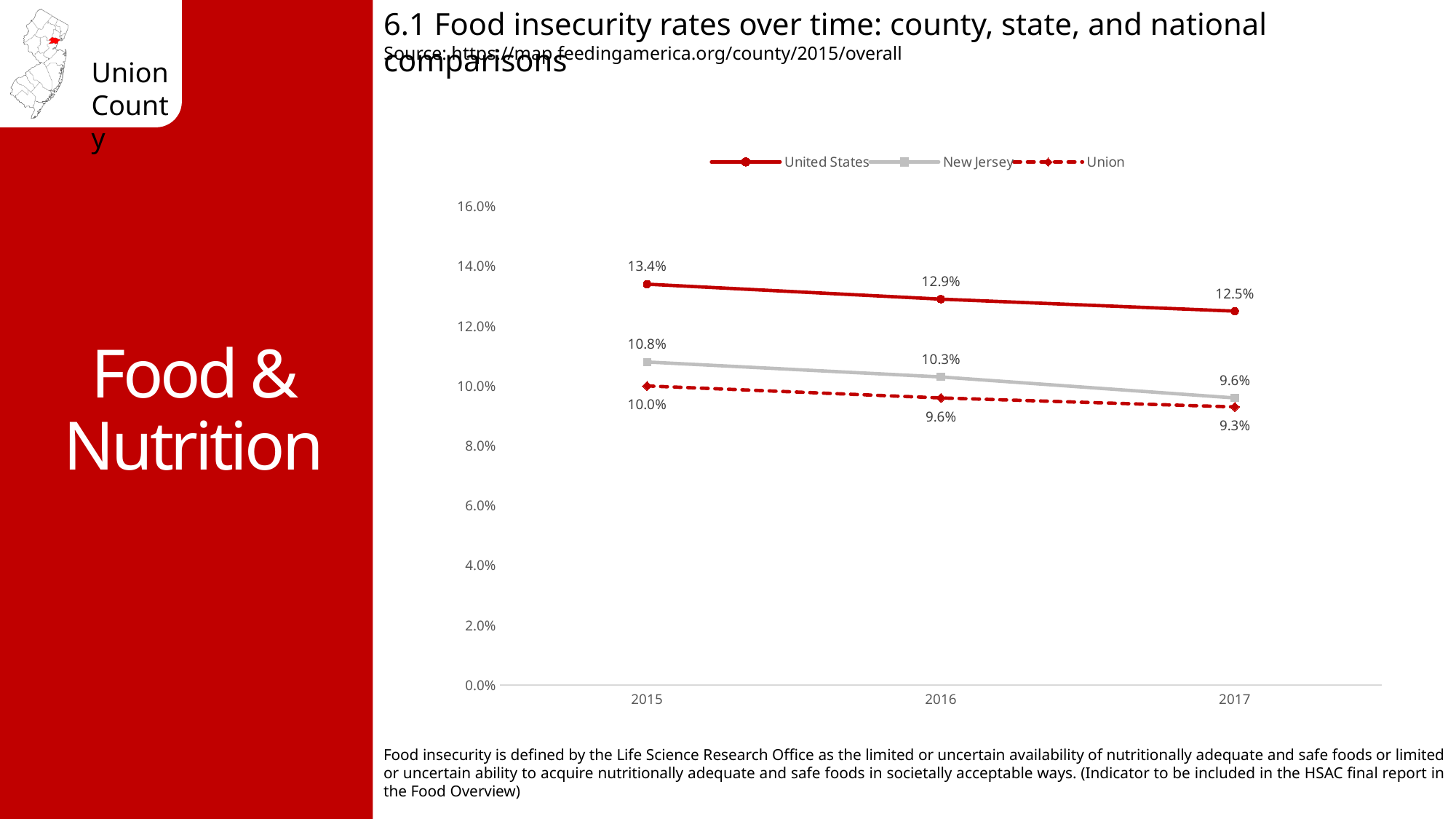
How many years are shown on the x axis? 3 Which year had the lowest food insecurity rate for New Jersey? 2017 How many series does the legend list? 3 What was the food insecurity rate for New Jersey in 2016? 10.3% What was the food insecurity rate for Union in 2017? 9.3% Does the food insecurity rate for the United States rise or fall from 2015 to 2017? Fall What was the food insecurity rate for Union in 2015? 10.0% Which had a higher food insecurity rate in 2016, New Jersey or Union? New Jersey What kind of chart is shown on the slide? Line chart What is the difference between the United States and Union food insecurity rates in 2017? 3.2% What was the food insecurity rate for the United States in 2015? 13.4% Which year had the highest food insecurity rate for the United States? 2015